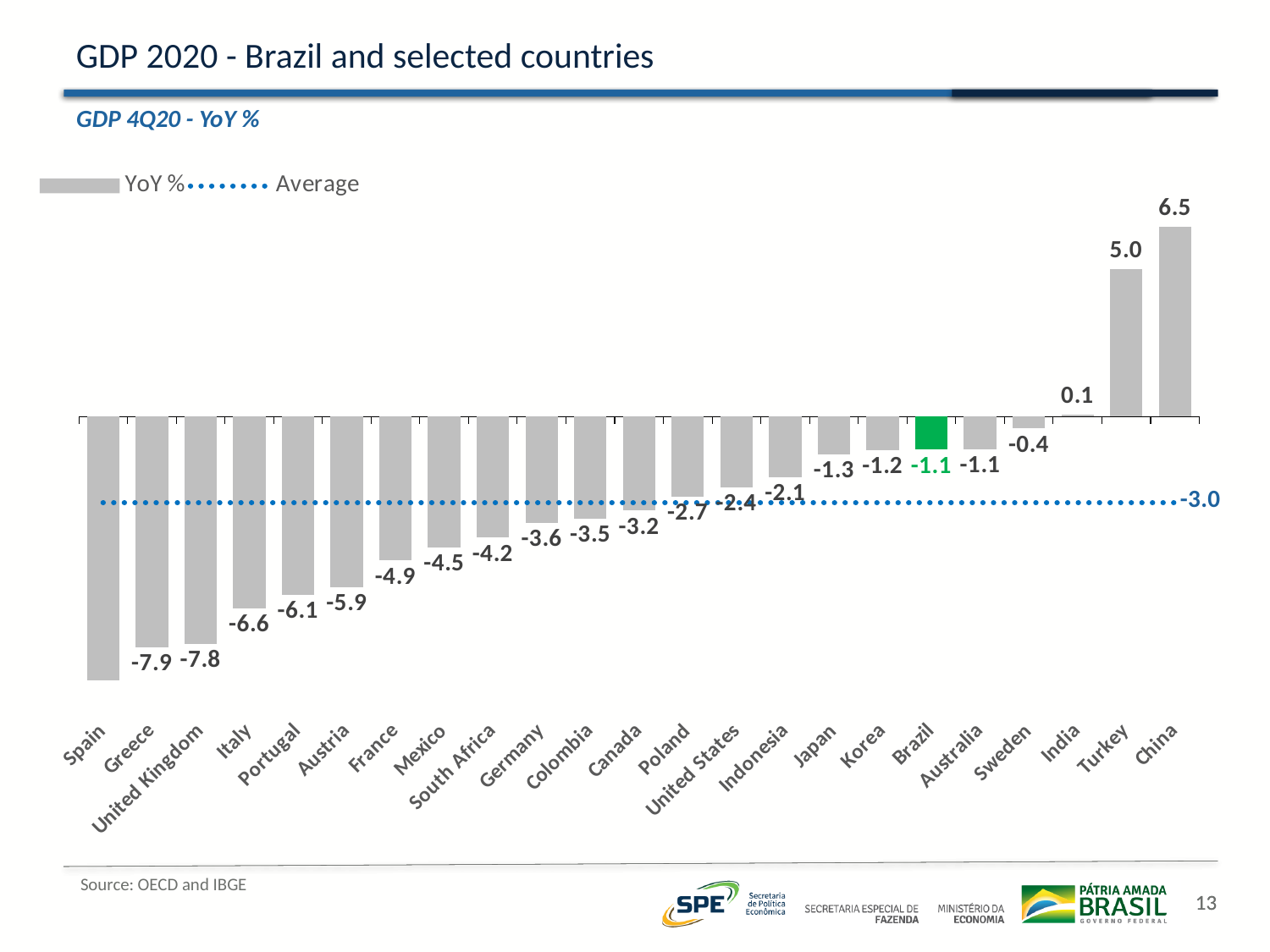
What is the GDP 4Q20 YoY % value for Brazil? -1.1 Which country has the highest GDP 4Q20 YoY % value? China Do the values rise or fall moving from left to right along the x axis? Rise Which country's bar is coloured green? Brazil What is the GDP 4Q20 YoY % value for China? 6.5 How many countries are shown on the chart? 23 What is the value of the Average line shown on the chart? -3.0 Which country has the lowest GDP 4Q20 YoY % value? Spain Which has the larger GDP 4Q20 YoY % value, Germany or Japan? Japan How many series does the legend list? 2 What is the difference between the values for China and Turkey? 1.5 What kind of chart is shown on the slide? Bar chart